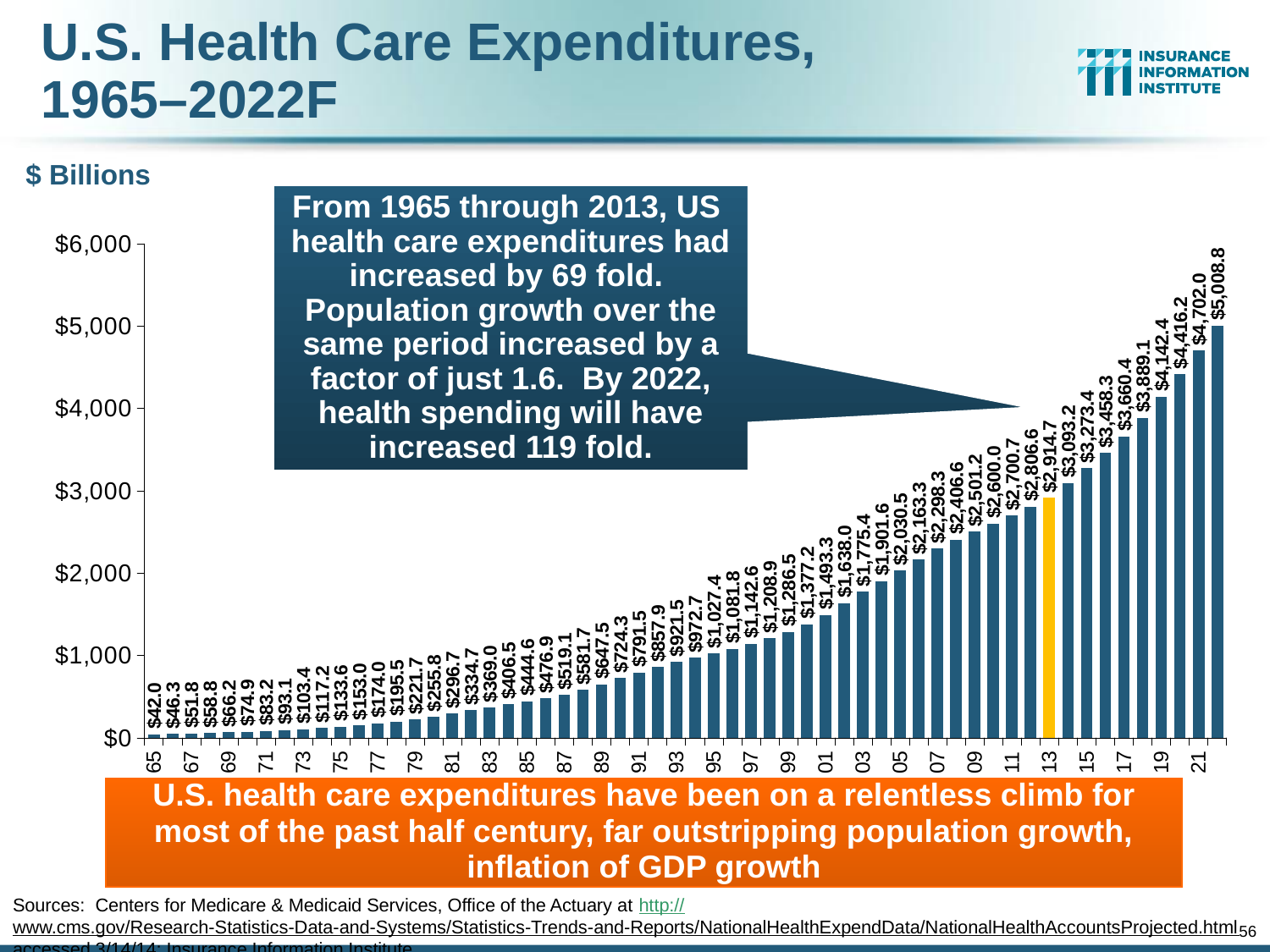
What is the difference between the last bar ($5,008.8) and the 2021 bar ($4,702.0)? $306.8 What is the value of the bar for 2001? $1,493.3 Which is larger, the value for 2001 or the value for 1991? 2001 What value is shown on the highlighted (yellow) bar for 2013? $2,914.7 How many bars are plotted in the chart? 58 What kind of chart is shown on the slide? Bar chart Which year has the lowest health care expenditure in the chart? 1965 Is the value for 2009 greater or less than $2,000? greater Do the values rise or fall from 1965 to 2022 along the x axis? Rise What is the value of the first bar (1965) in the chart? $42.0 What is the difference between the 2013 value ($2,914.7) and the 1965 value ($42.0)? $2,872.7 What is the highest value shown in the chart? $5,008.8